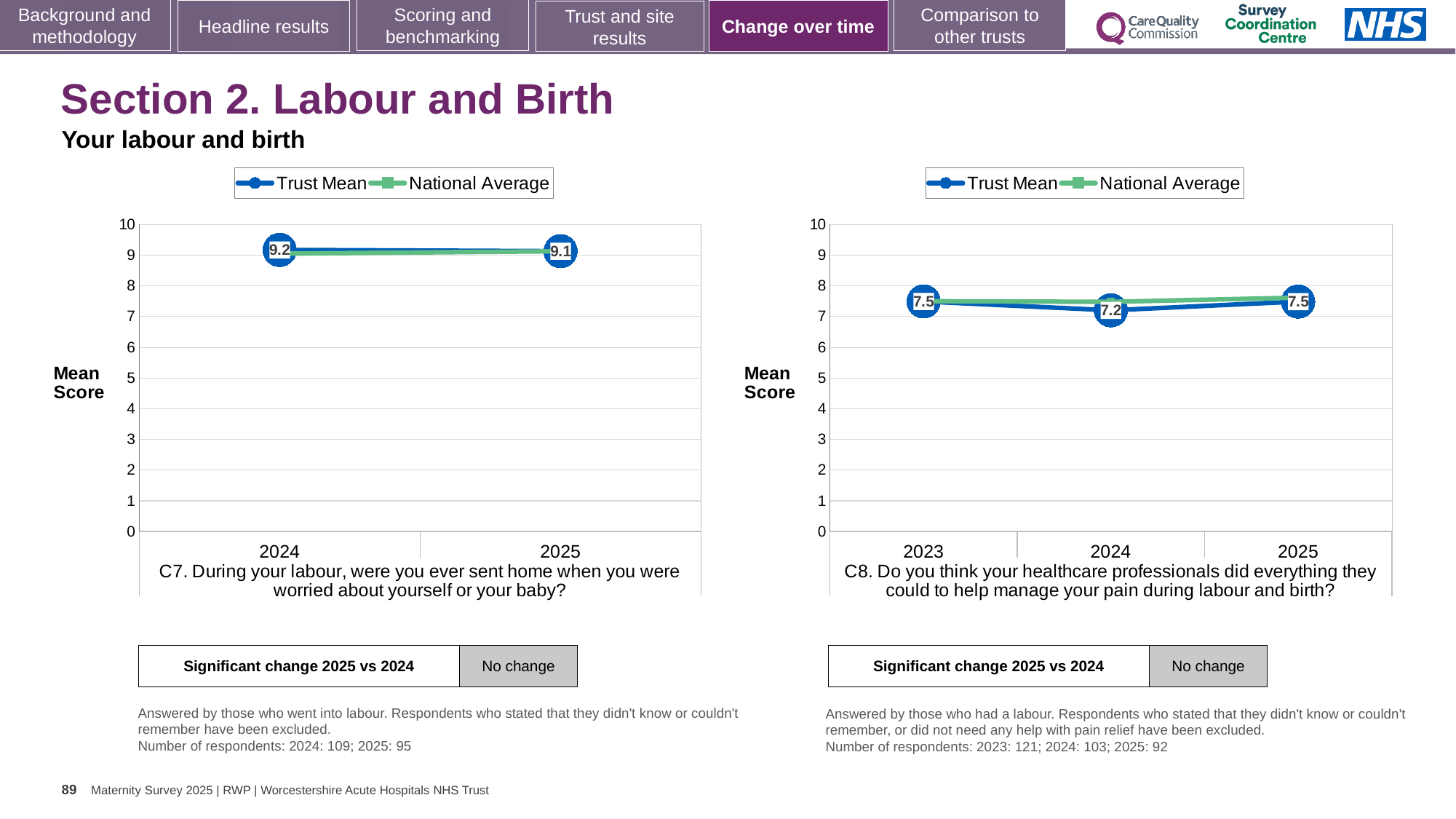
In the left chart (C7), what is the Trust Mean score for 2025? 9.1 In the right chart (C8), what is the Trust Mean score for 2024? 7.2 In the left chart (C7), what is the Trust Mean score for 2024? 9.2 What type of chart is the right chart (C8)? line chart In the left chart (C7), does the Trust Mean rise or fall from 2024 to 2025? fall In the right chart (C8), what is the difference between the Trust Mean for 2023 and 2024? 0.3 In the left chart (C7), how many years are plotted on the x axis? 2 In the right chart (C8), which year has the lowest Trust Mean score? 2024 In the right chart (C8), how many series does the legend list? 2 In the left chart (C7), by how much did the Trust Mean change from 2024 to 2025? 0.1 In the left chart (C7), is the National Average for 2024 greater or less than 8? greater In the right chart (C8), what is the Trust Mean score for 2023? 7.5